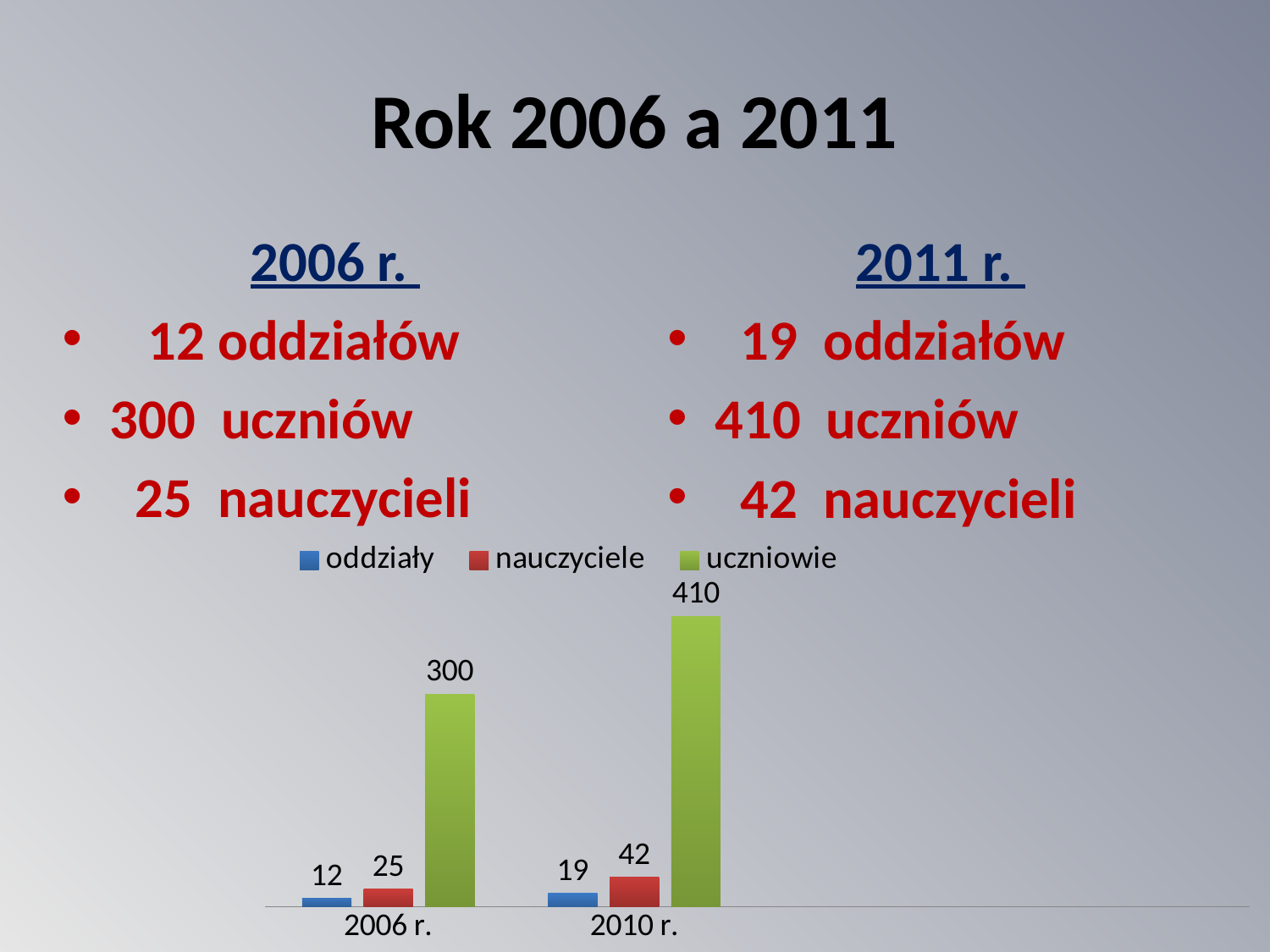
Which colour represents the uczniowie series in the legend? green What type of chart is shown on the slide? bar chart What is the value of nauczyciele for 2010 r.? 42 What is the difference between the uczniowie values for 2010 r. and 2006 r.? 110 How many series does the chart legend list? 3 What is the value of oddziały for 2006 r.? 12 Which series has the highest value for 2010 r.? uczniowie What is the value of uczniowie for 2006 r.? 300 How many categories are shown on the x axis? 2 Which series has the lowest value for 2006 r.? oddziały Which is larger: nauczyciele for 2006 r. or nauczyciele for 2010 r.? 2010 r. What is the value of uczniowie for 2010 r.? 410